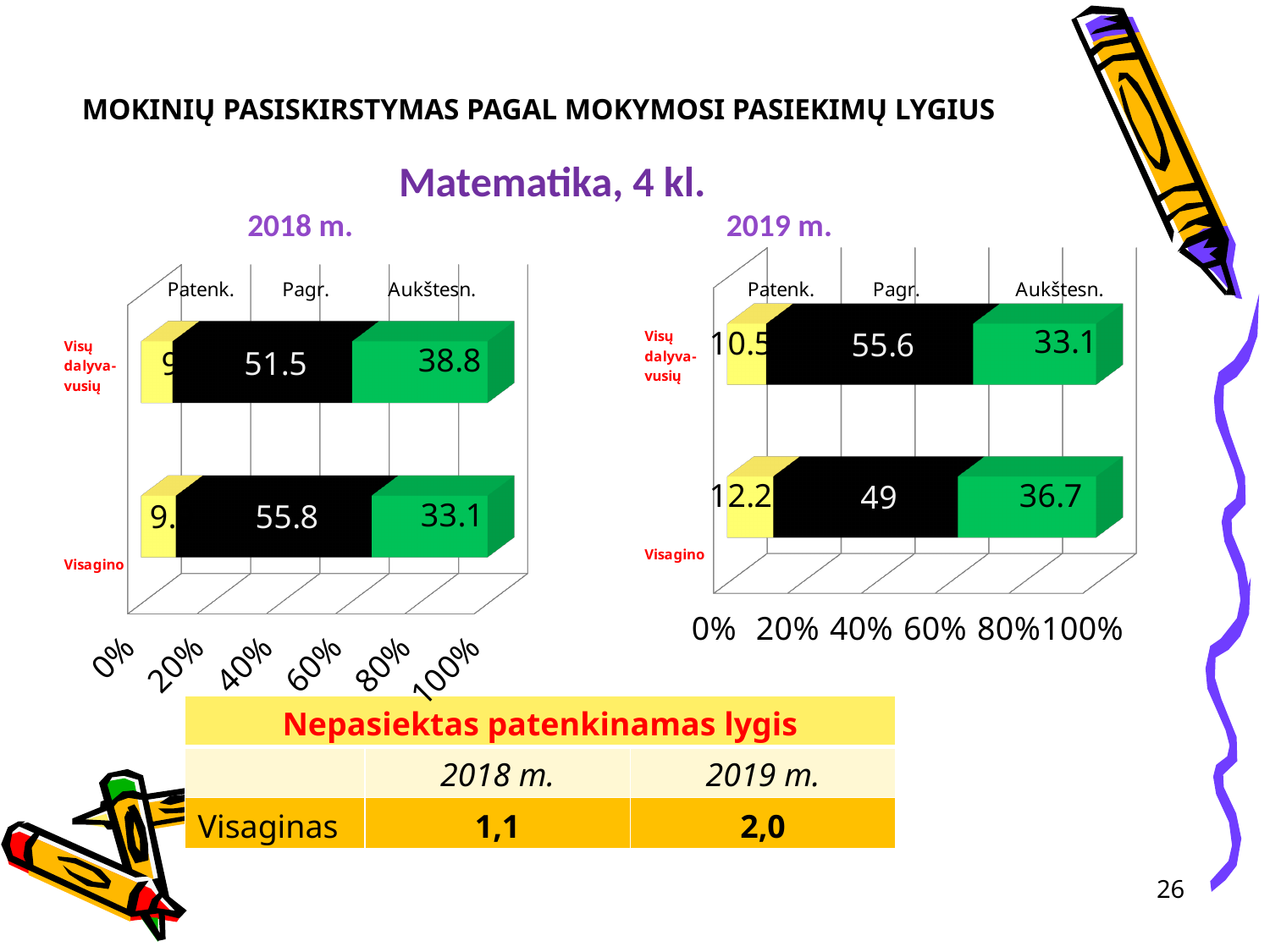
In the 2018 m. chart, what is the difference between the Pagr. values for Visagino and Visų dalyvavusių? 4.3 How many series does the 2019 m. chart show? 3 In the 2018 m. chart, what is the Pagr. value for Visų dalyvavusių? 51.5 What kind of chart is the 2018 m. chart? Stacked bar chart How many categories (rows) does the 2018 m. chart show? 2 In the 2019 m. chart, what is the difference between the Pagr. values for Visų dalyvavusių and Visagino? 6.6 In the 2019 m. chart, what is the Patenk. value for Visagino? 12.2 In the 2019 m. chart, what is the Pagr. value for Visų dalyvavusių? 55.6 In the 2019 m. chart, which has the larger Aukštesn. value, Visagino or Visų dalyvavusių? Visagino In the 2018 m. chart, what is the Aukštesn. value for Visagino? 33.1 In the 2019 m. chart, what is the Patenk. value for Visų dalyvavusių? 10.5 In the 2019 m. chart, what is the Aukštesn. value for Visagino? 36.7